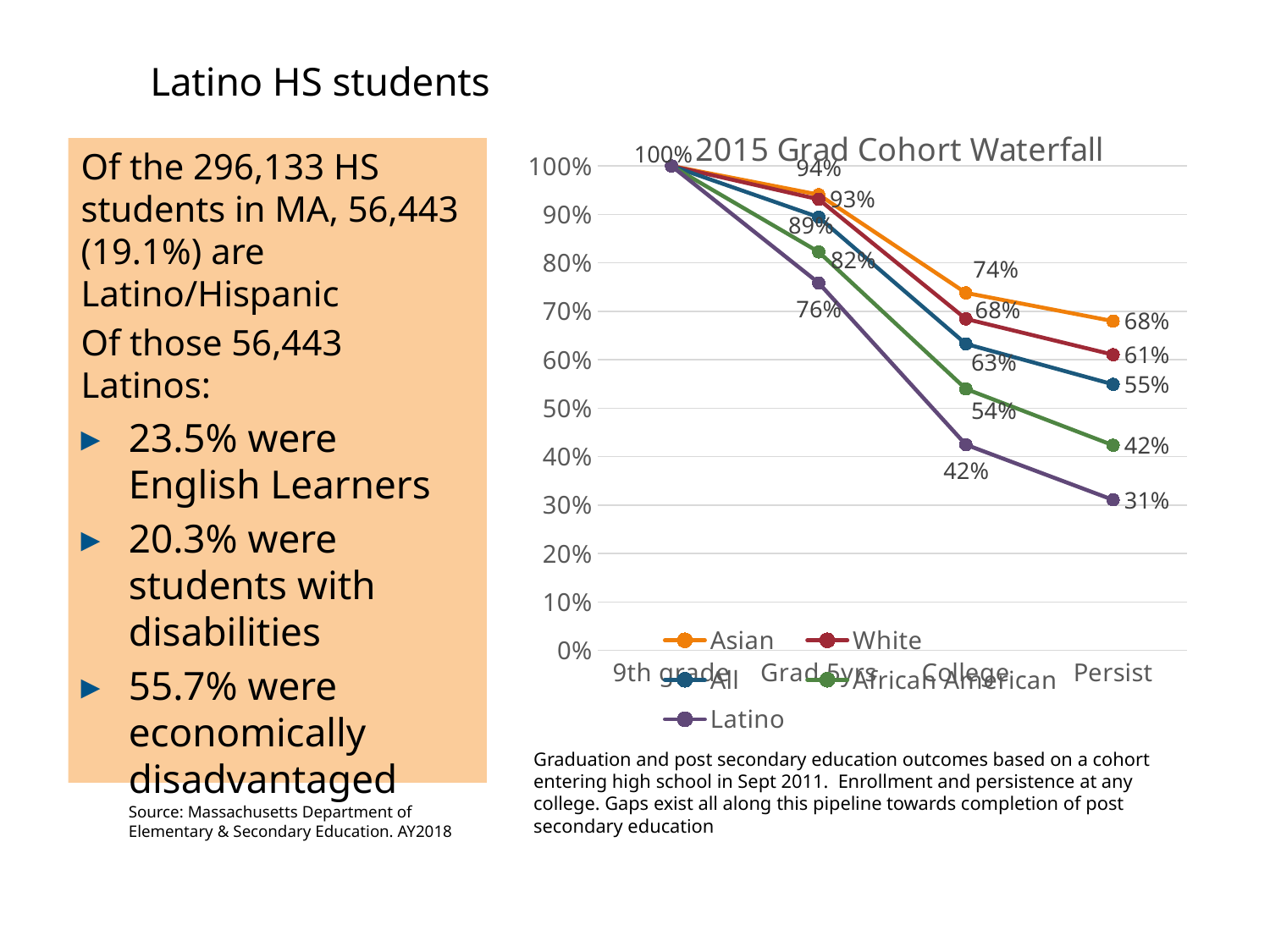
Which series has the highest value at College in the 2015 Grad Cohort Waterfall chart? Asian What is the Persist value for Latino students in the 2015 Grad Cohort Waterfall chart? 31% Do the values for each series rise or fall from 9th grade to Persist in the 2015 Grad Cohort Waterfall chart? Fall How many series does the legend of the 2015 Grad Cohort Waterfall chart list? 5 What is the Persist value for the All series in the 2015 Grad Cohort Waterfall chart? 55% Which series has the lowest value at Persist in the 2015 Grad Cohort Waterfall chart? Latino What kind of chart is the 2015 Grad Cohort Waterfall? Line chart Which is larger at Grad 5yrs in the 2015 Grad Cohort Waterfall chart: the White value or the African American value? White How many stages are shown along the x axis of the 2015 Grad Cohort Waterfall chart? 4 What is the College value for Asian students in the 2015 Grad Cohort Waterfall chart? 74% What is the difference between the Asian and Latino Persist values in the 2015 Grad Cohort Waterfall chart? 37% What colour is the Latino line in the 2015 Grad Cohort Waterfall chart? Purple